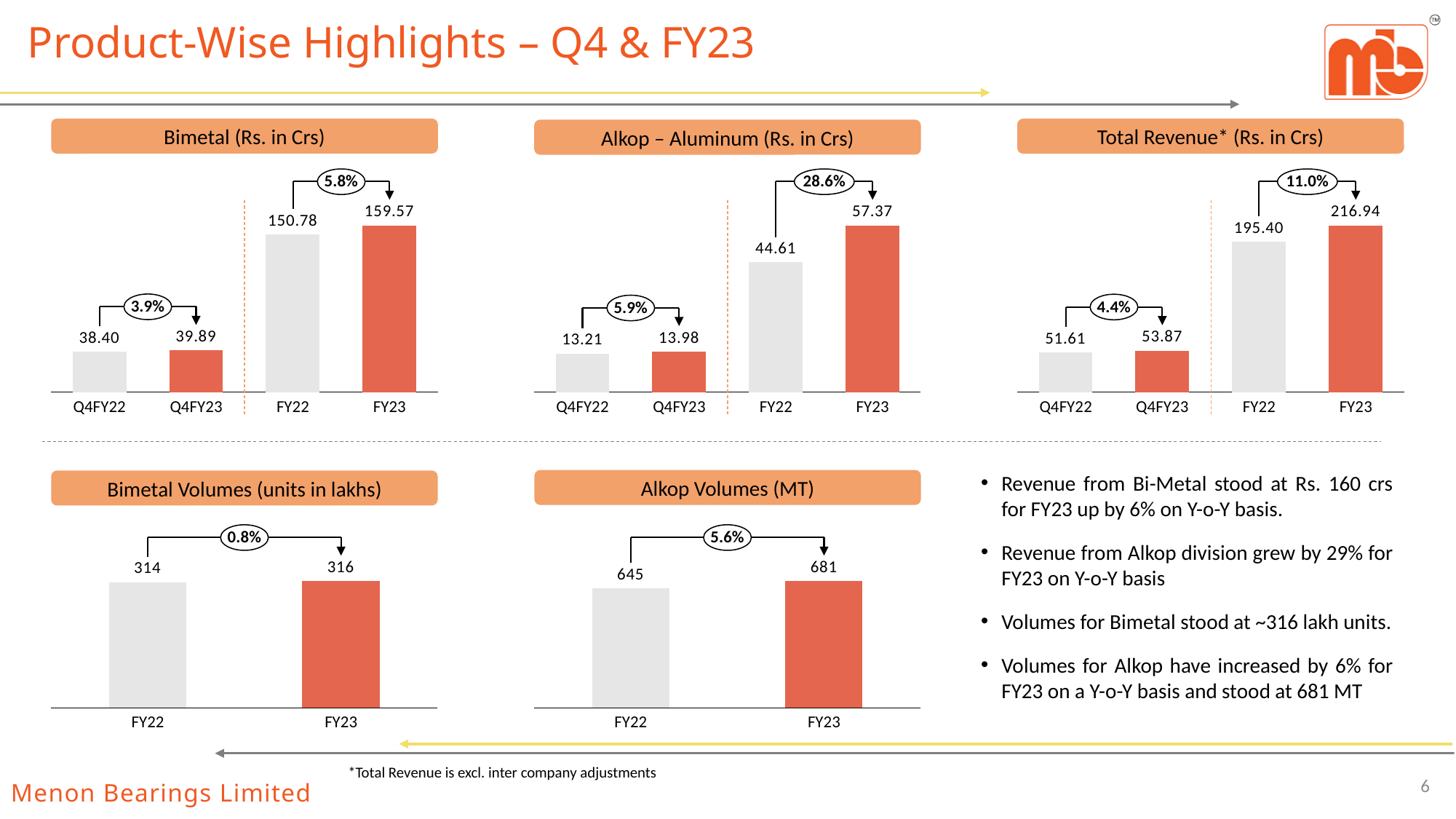
In the Alkop Volumes (MT) chart, what is the value for FY23? 681 How many bars are plotted in the Alkop – Aluminum (Rs. in Crs) chart? 4 In the Total Revenue* (Rs. in Crs) chart, what is the value for FY22? 195.40 In the Alkop – Aluminum (Rs. in Crs) chart, what is the difference between the FY23 and FY22 values? 12.76 In the Bimetal (Rs. in Crs) chart, what is the value for FY23? 159.57 In the Alkop – Aluminum (Rs. in Crs) chart, what is the value for Q4FY22? 13.21 What growth percentage is shown between FY22 and FY23 in the Alkop – Aluminum (Rs. in Crs) chart? 28.6% In the Total Revenue* (Rs. in Crs) chart, which is larger, Q4FY23 or Q4FY22? Q4FY23 In the Bimetal (Rs. in Crs) chart, which category has the highest value? FY23 In the Bimetal Volumes (units in lakhs) chart, what is the difference between FY23 and FY22? 2 In the Total Revenue* (Rs. in Crs) chart, which category has the lowest value? Q4FY22 What kind of chart is the Bimetal Volumes (units in lakhs) chart? Bar chart